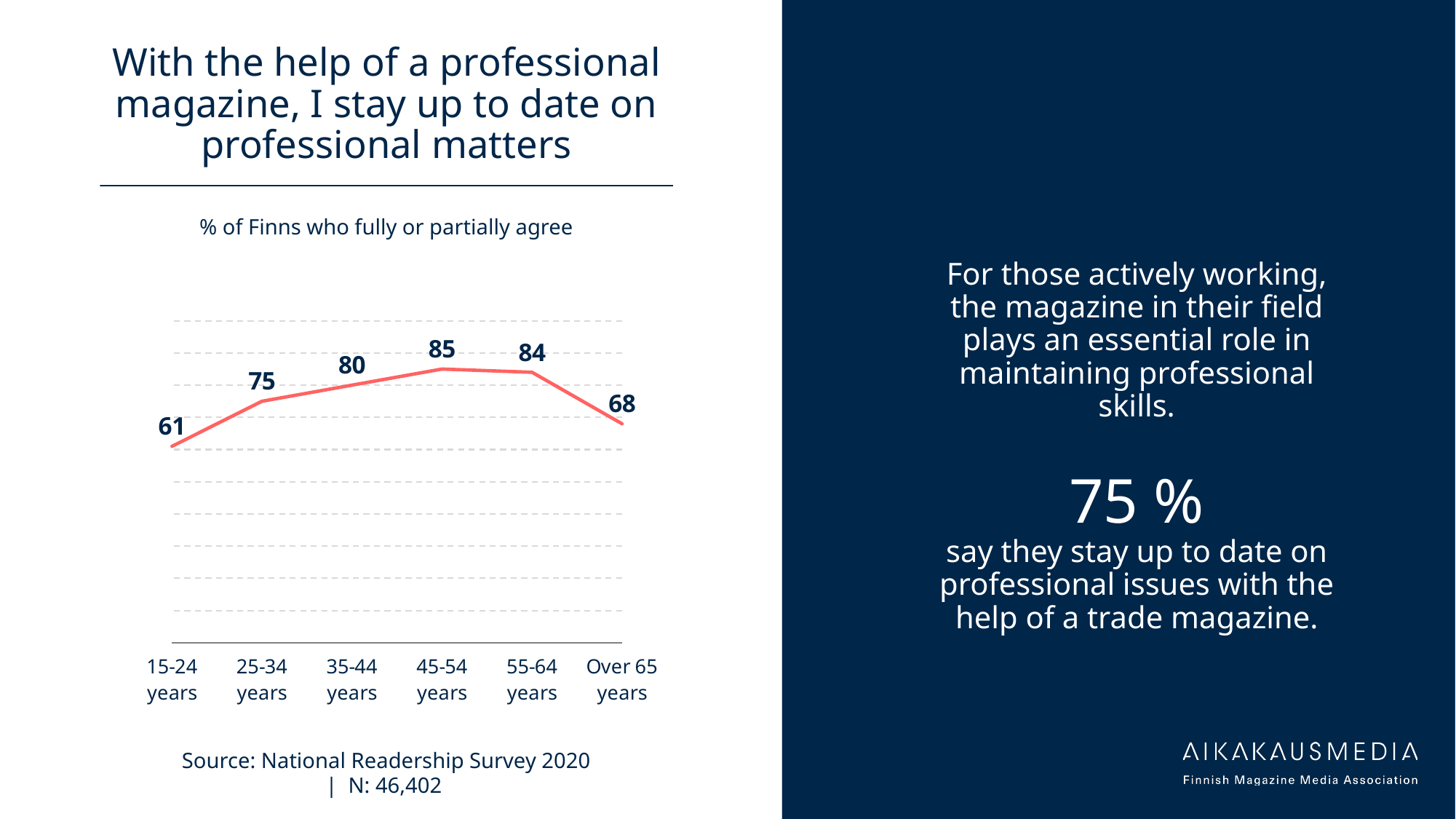
Which is larger, the value for 25-34 years or the value for Over 65 years? 25-34 years What is the difference between the values for 45-54 years and 15-24 years? 24 What percentage of Finns aged 15-24 years fully or partially agree that a professional magazine helps them stay up to date on professional matters? 61 Which age group has the highest value? 45-54 years How many age groups are plotted on the chart? 6 What kind of chart is shown on the slide? Line chart What is the subtitle shown above the chart? % of Finns who fully or partially agree What is the difference between the values for 55-64 years and Over 65 years? 16 What is the value for the 45-54 years age group? 85 Do the values rise or fall from 15-24 years to 45-54 years? Rise What is the value for the Over 65 years age group? 68 Which age group has the lowest value? 15-24 years